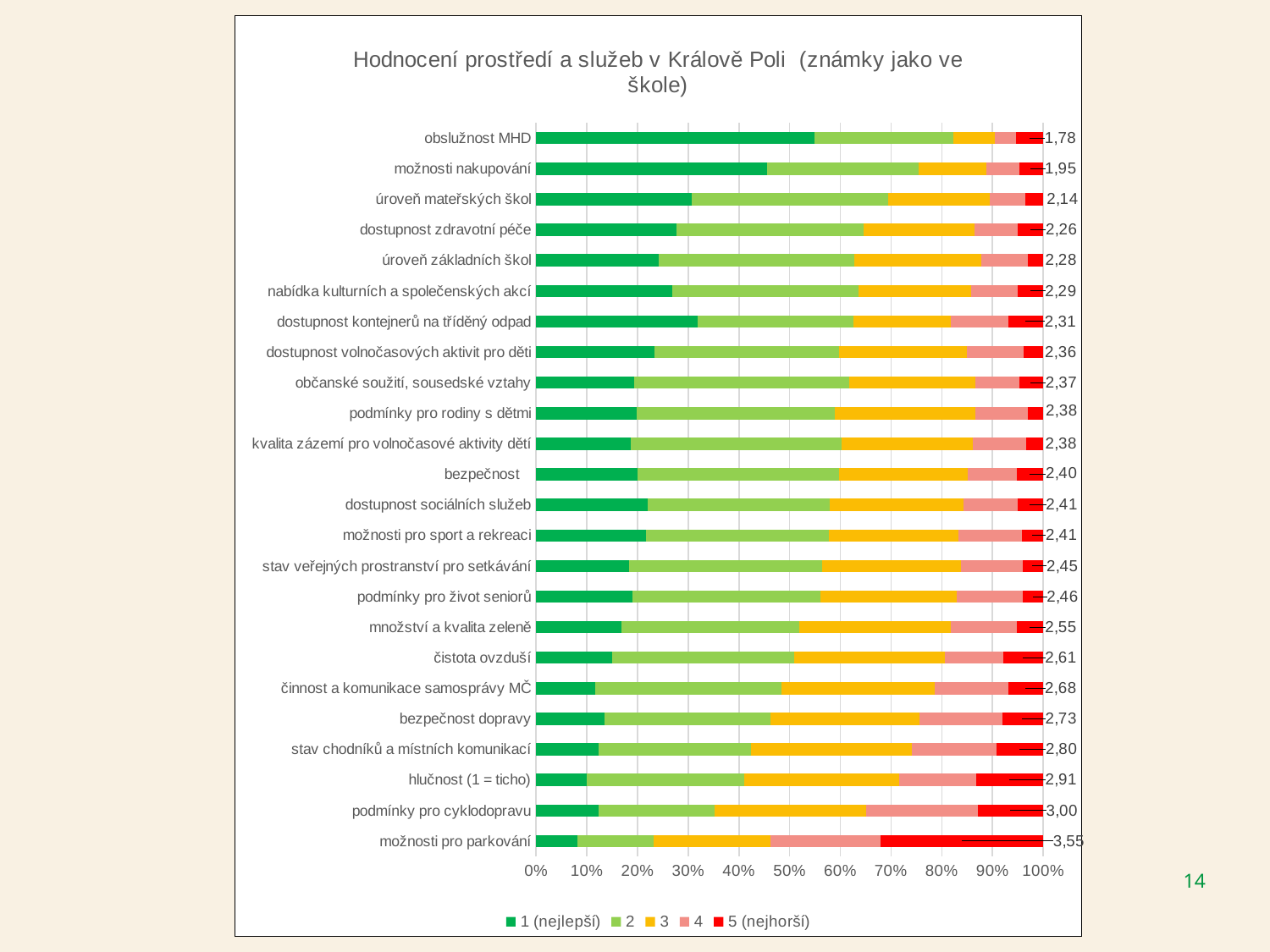
Which has a higher average grade label: podmínky pro cyklodopravu or bezpečnost dopravy? podmínky pro cyklodopravu How many series does the legend list? 5 Which category has the lowest (best) average grade label? obslužnost MHD Is the share of grade 1 (nejlepší) for možnosti pro parkování greater or less than 10%? less What kind of chart is shown on the slide? stacked bar chart How many categories are plotted in the chart? 24 What is the difference between the average grade for možnosti pro parkování and obslužnost MHD? 1,77 What average grade is shown for hlučnost (1 = ticho)? 2,91 What average grade is shown for obslužnost MHD? 1,78 What average grade is shown for možnosti pro parkování? 3,55 Which category has the highest (worst) average grade label? možnosti pro parkování Is the share of grade 1 (nejlepší) for obslužnost MHD greater or less than 50%? greater